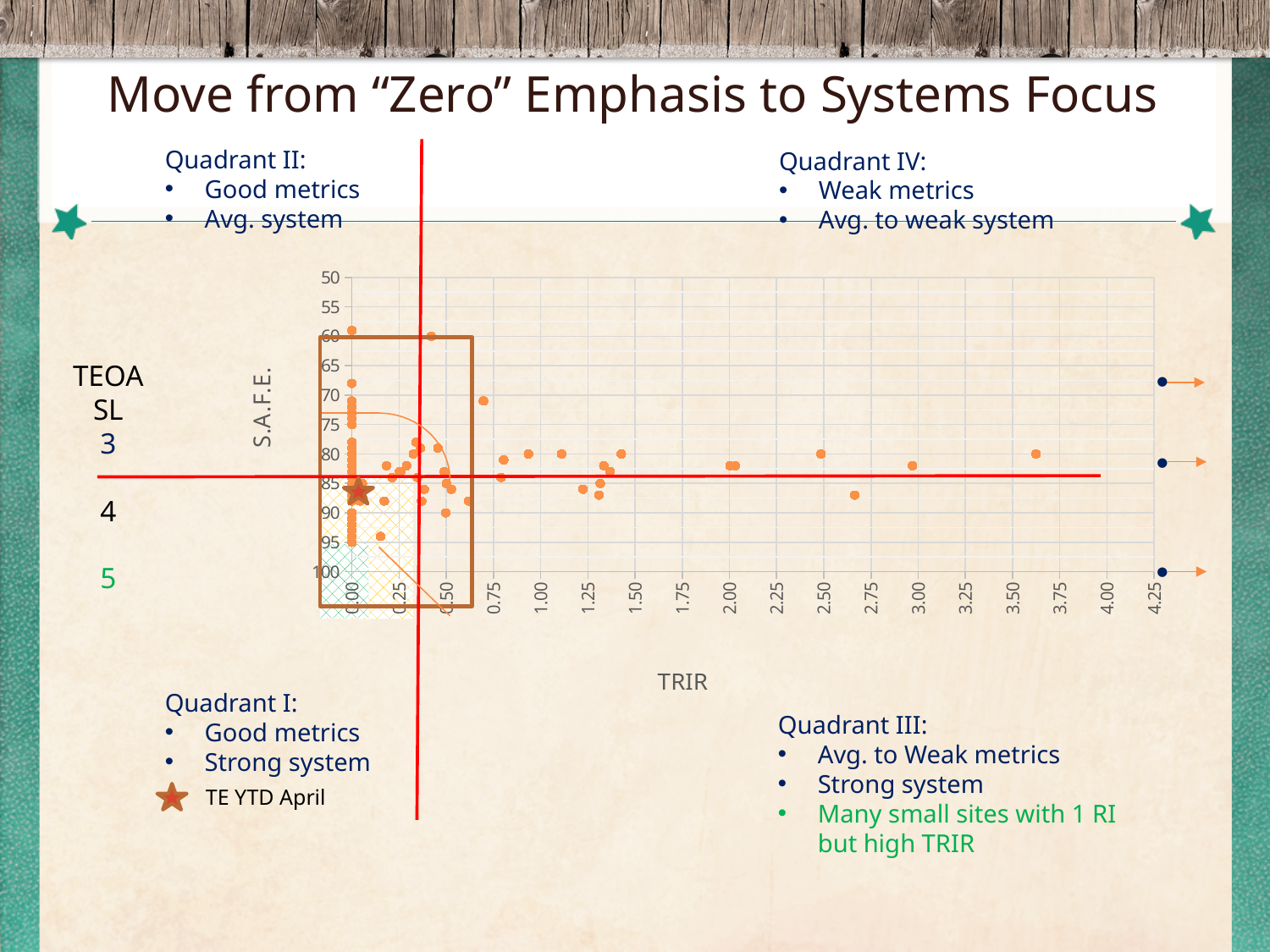
What is the title of the vertical axis of the chart? S.A.F.E. What kind of chart is shown on the slide? scatter chart Is the TRIR value of the rightmost plotted point (near S.A.F.E. 80) greater or less than 3.00? greater Is the TRIR value of the plotted point at about S.A.F.E. 70 that lies to the right of the red vertical line greater or less than 0.50? greater What is the title of the horizontal axis of the chart? TRIR Is the TRIR value of the point plotted at about S.A.F.E. 87 near the 2.75 tick greater or less than 2.50? greater